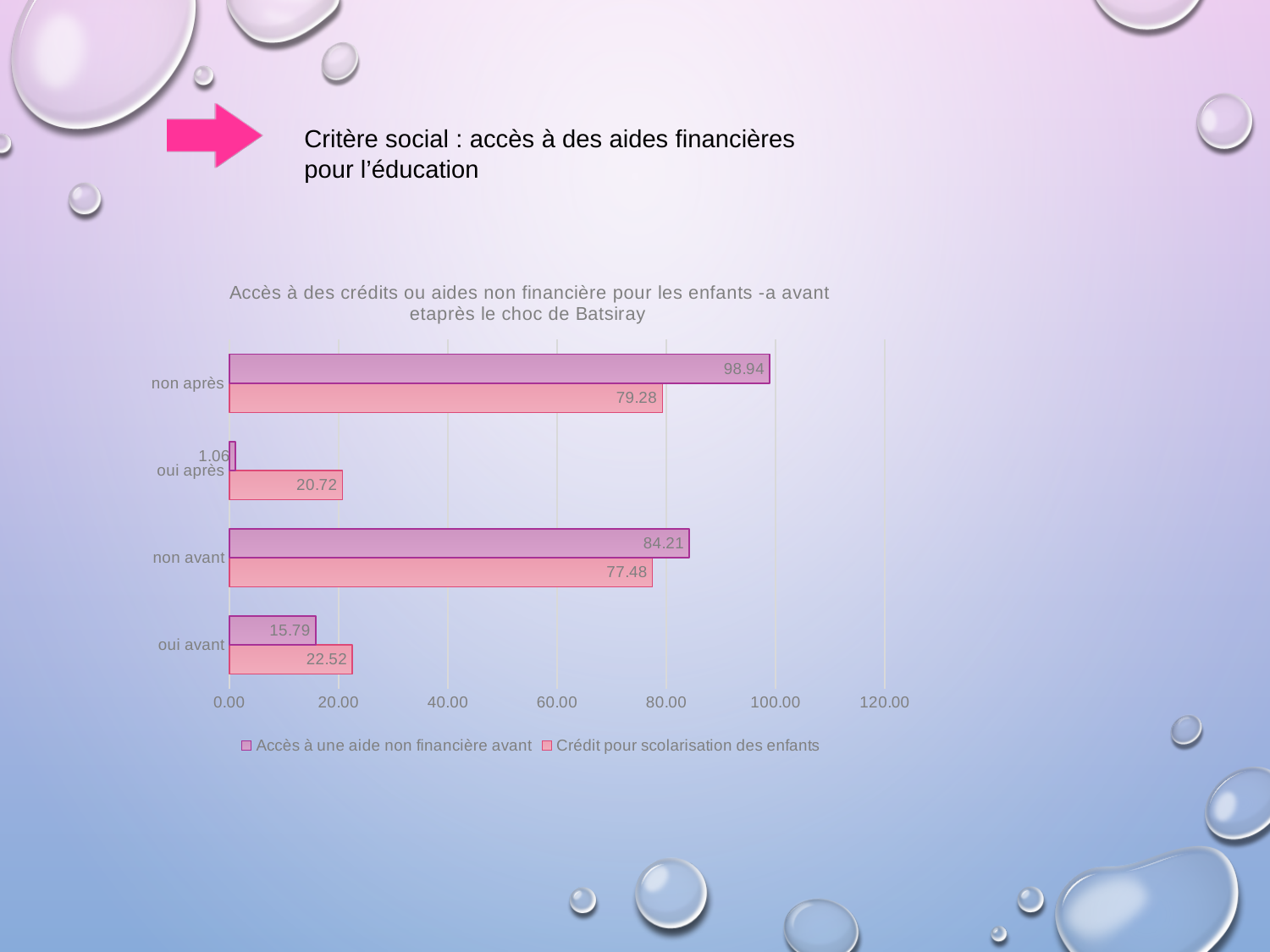
What is the difference between the two series' values for "non après"? 19.66 What kind of chart is shown on the slide? Bar chart For "non avant", which series has the larger value? Accès à une aide non financière avant What is the difference between the two series' values for "oui avant"? 6.73 What is the value for "non avant" in the "Crédit pour scolarisation des enfants" series? 77.48 What is the value for "oui après" in the "Crédit pour scolarisation des enfants" series? 20.72 How many categories are shown on the chart? 4 What is the value for "non après" in the "Accès à une aide non financière avant" series? 98.94 How many series does the legend list? 2 What is the value for "oui avant" in the "Accès à une aide non financière avant" series? 15.79 Which category has the highest value in the "Accès à une aide non financière avant" series? non après Which category has the lowest value in the "Accès à une aide non financière avant" series? oui après